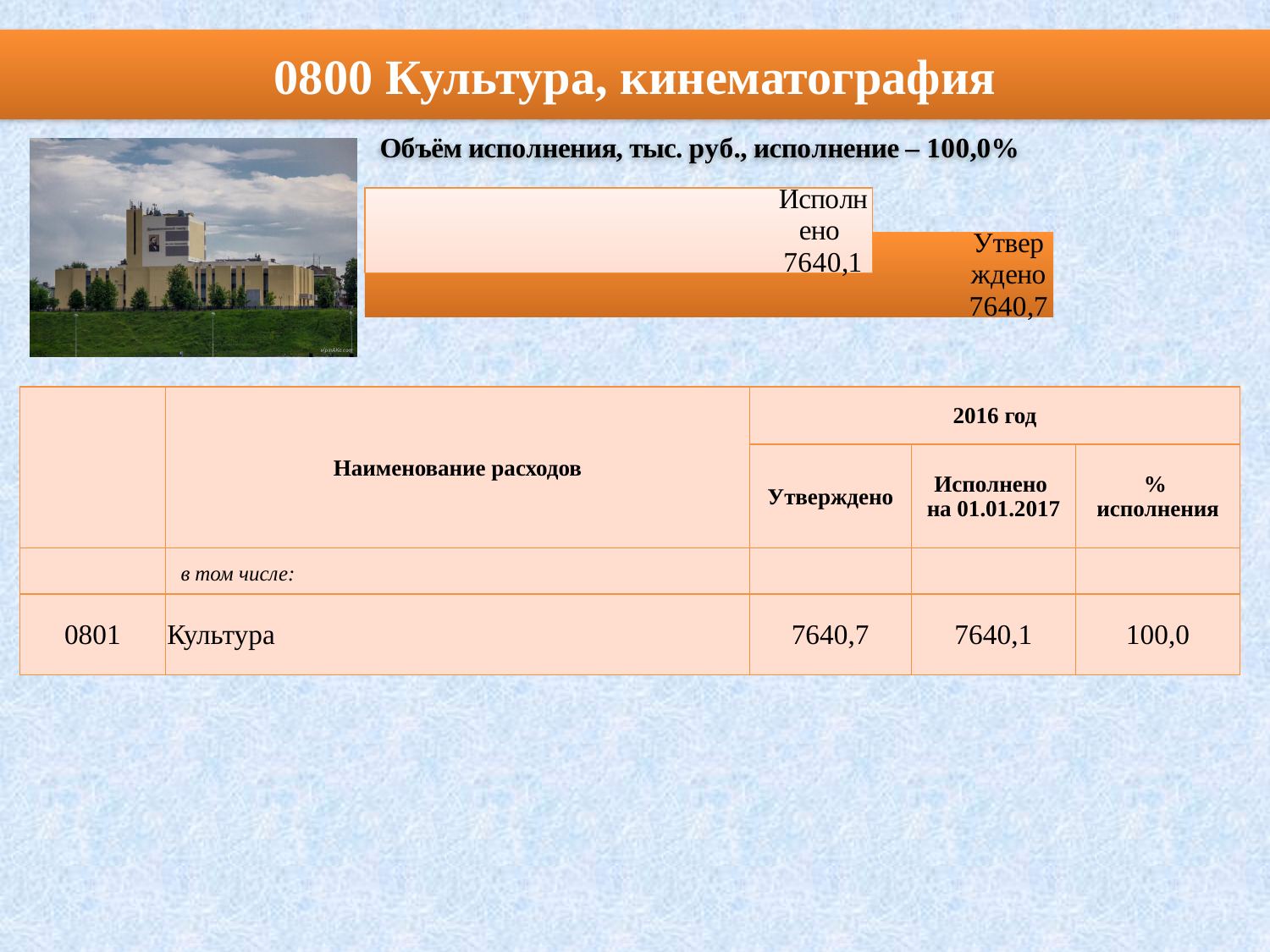
Which bar in the chart has the higher value, Исполнено or Утверждено? Утверждено What is the difference between the Утверждено and Исполнено values in the chart? 0,6 Which bar in the chart shows the lowest value? Исполнено What is the value of the Исполнено bar in the chart? 7640,1 How many bars are plotted in the chart? 2 What is the title of the chart on the slide? Объём исполнения, тыс. руб., исполнение – 100,0% What kind of chart is shown on the slide? bar chart Which bar in the chart shows the highest value? Утверждено What unit of measurement does the chart title state for the values? тыс. руб. What is the value of the Утверждено bar in the chart? 7640,7